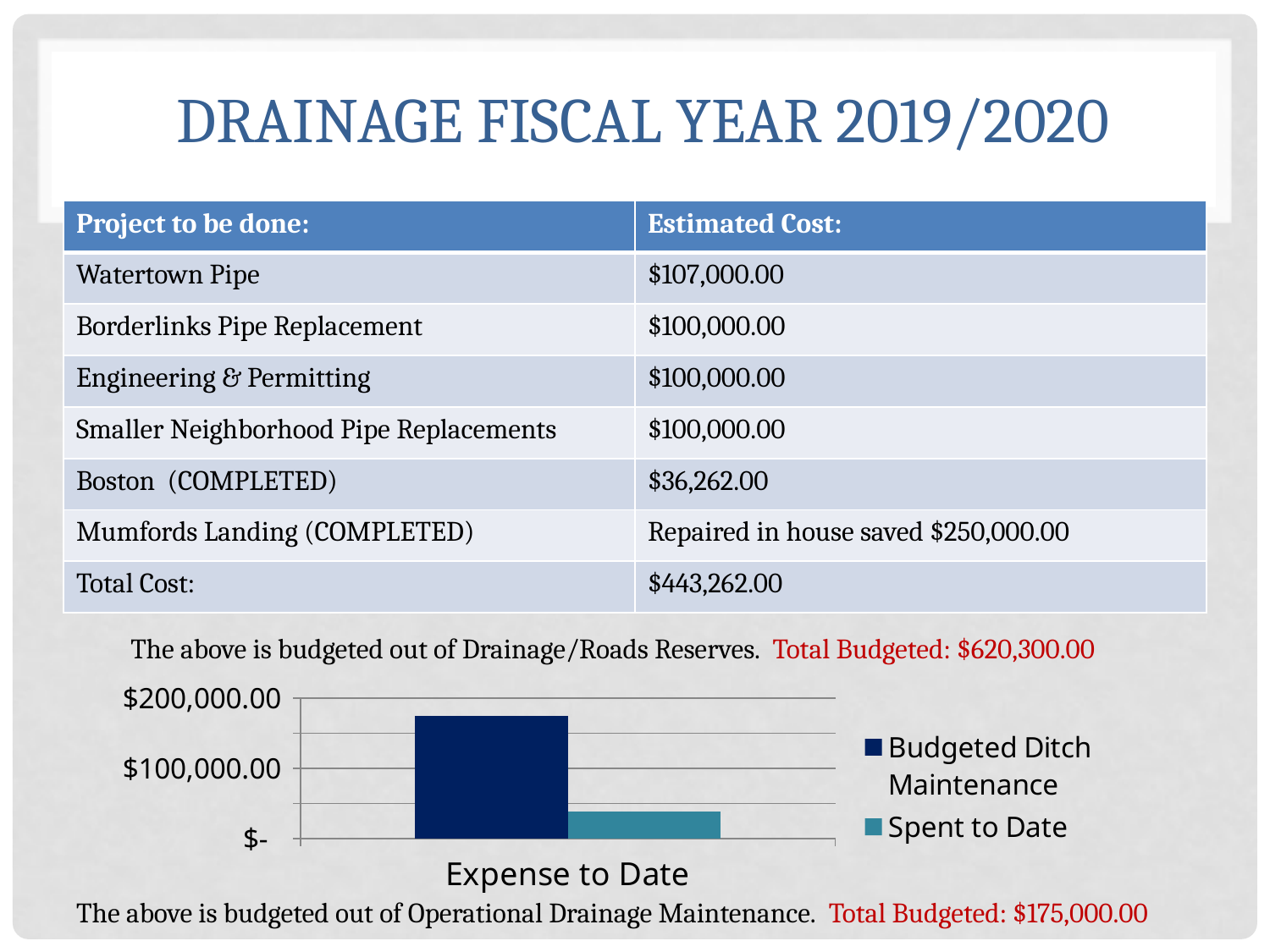
What is the category label shown on the chart's x axis? Expense to Date Which series has the taller bar, Budgeted Ditch Maintenance or Spent to Date? Budgeted Ditch Maintenance What is the highest value shown on the chart's vertical axis? $200,000.00 How many categories are plotted on the chart's x axis? 1 Is the value for Budgeted Ditch Maintenance greater or less than $100,000.00? greater Which series is shown in the lighter teal colour in the legend? Spent to Date Which series has the lowest bar on the chart? Spent to Date Is the value for Budgeted Ditch Maintenance greater or less than $200,000.00? less What kind of chart is shown on the slide? bar chart How many series does the chart's legend list? 2 Is the value for Spent to Date greater or less than $100,000.00? less